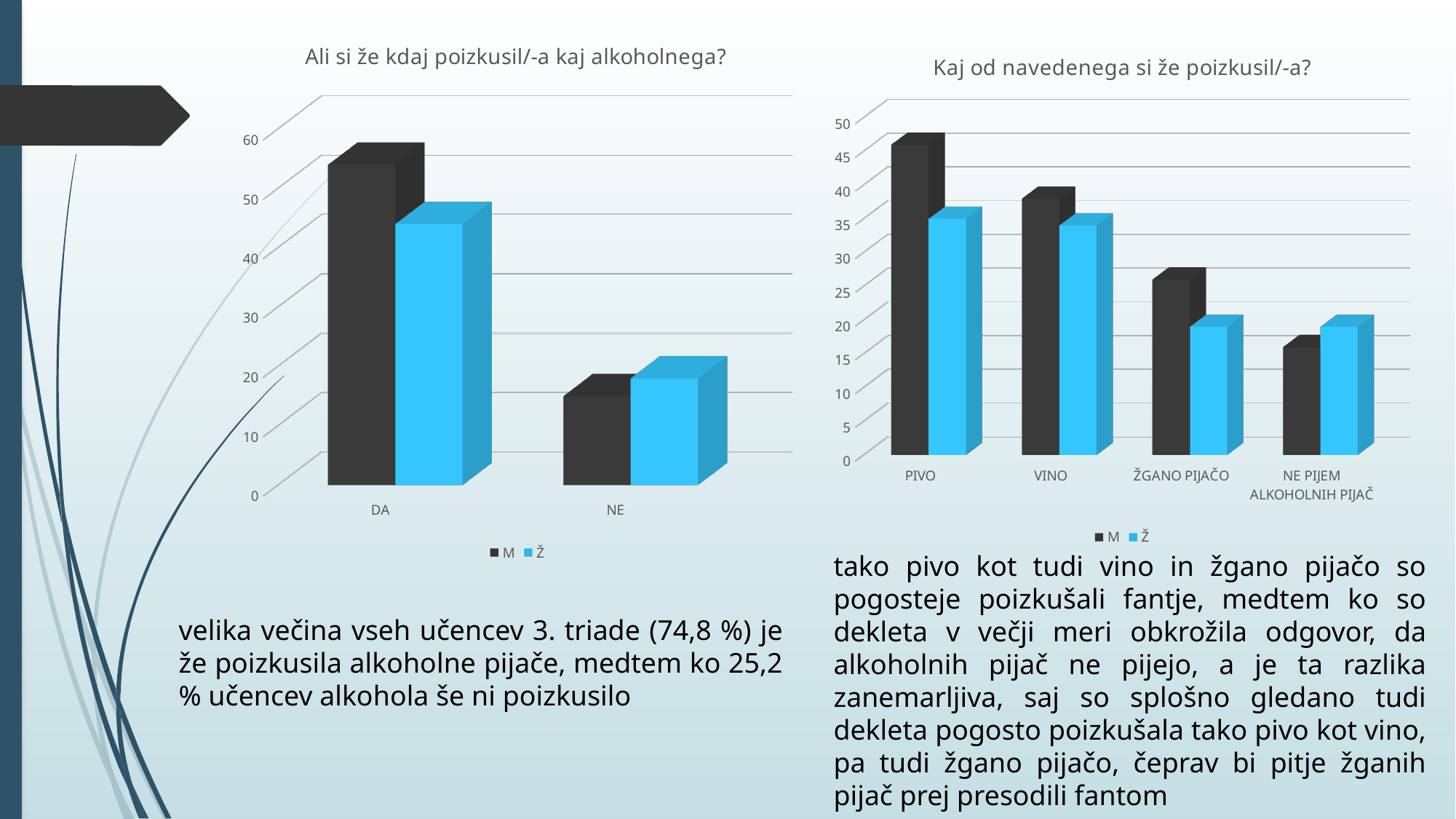
What kind of chart is the left chart titled "Ali si že kdaj poizkusil/-a kaj alkoholnega?"? bar chart How many categories are shown on the x axis of the right chart "Kaj od navedenega si že poizkusil/-a?"? 4 In the right chart "Kaj od navedenega si že poizkusil/-a?", which category has the highest value for the M series? PIVO What is the title of the right chart on the slide? Kaj od navedenega si že poizkusil/-a? In the right chart "Kaj od navedenega si že poizkusil/-a?", is the value for Ž in the ŽGANO PIJAČO category greater or less than 25? less In the left chart "Ali si že kdaj poizkusil/-a kaj alkoholnega?", is the value for M in the DA category greater or less than 50? greater In the right chart "Kaj od navedenega si že poizkusil/-a?", is the value for M in the PIVO category greater or less than 40? greater How many series does the legend of the left chart "Ali si že kdaj poizkusil/-a kaj alkoholnega?" list? 2 In the right chart "Kaj od navedenega si že poizkusil/-a?", which category has the lowest value for the M series? NE PIJEM ALKOHOLNIH PIJAČ In the right chart "Kaj od navedenega si že poizkusil/-a?", which series has the larger value for NE PIJEM ALKOHOLNIH PIJAČ, M or Ž? Ž In the left chart "Ali si že kdaj poizkusil/-a kaj alkoholnega?", which series has the larger value for DA, M or Ž? M